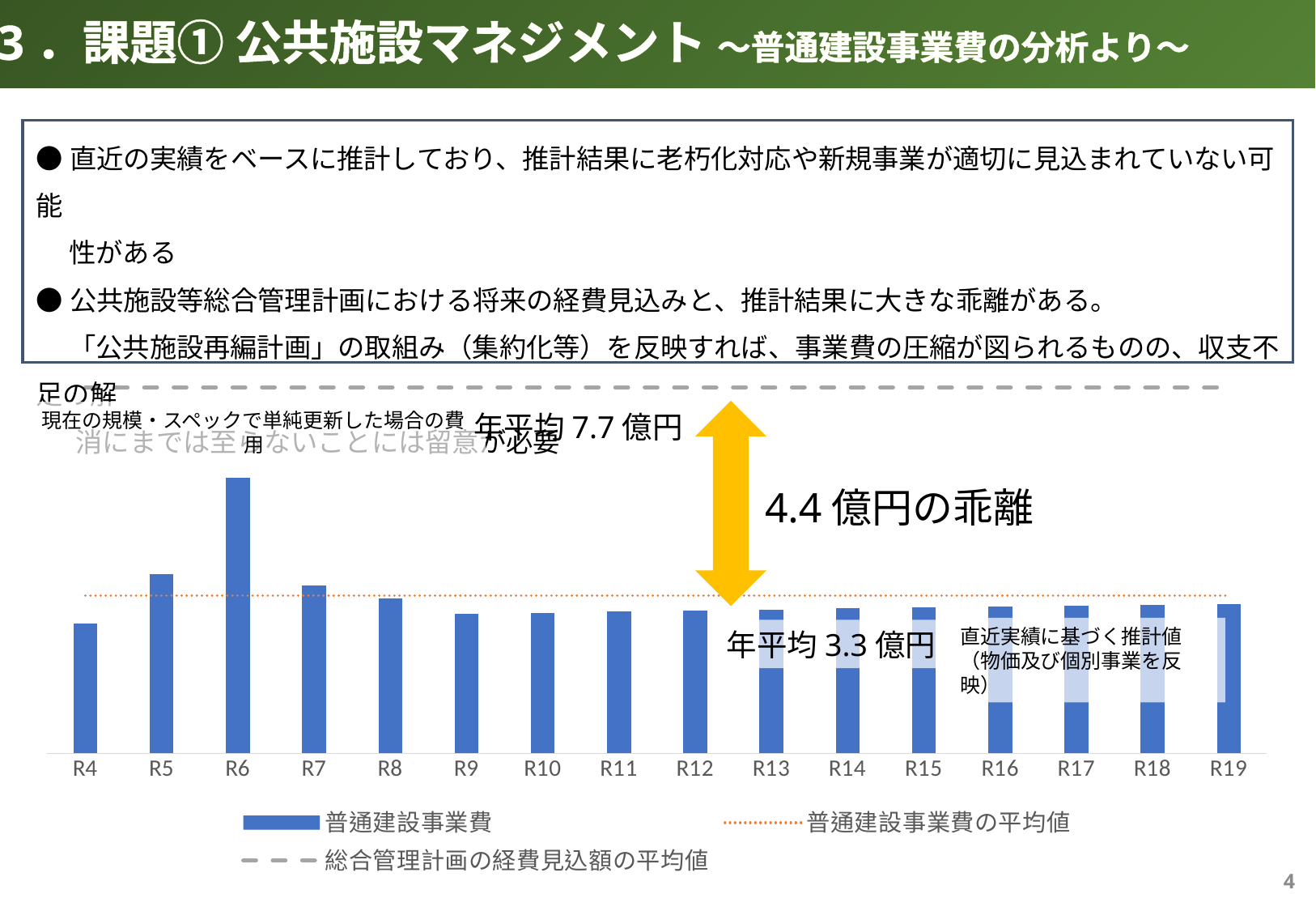
What is the gap (乖離) between the two average lines as labelled on the chart? 4.4 億円 Which bar is taller, R5 or R7? R5 Which year has the highest 普通建設事業費 bar? R6 Which year has the lowest 普通建設事業費 bar? R4 What annual average is shown for 普通建設事業費 (dotted line)? 年平均 3.3 億円 What does the dotted orange line in the legend represent? 普通建設事業費の平均値 How many series does the chart legend list? 3 How many fiscal-year categories are shown on the x axis of the chart? 16 Do the bars rise or fall from R6 to R9? fall Which bar is taller, R6 or R12? R6 What kind of chart is shown on the slide? bar chart What annual average is shown for the 総合管理計画の経費見込額 (dashed line)? 年平均 7.7 億円